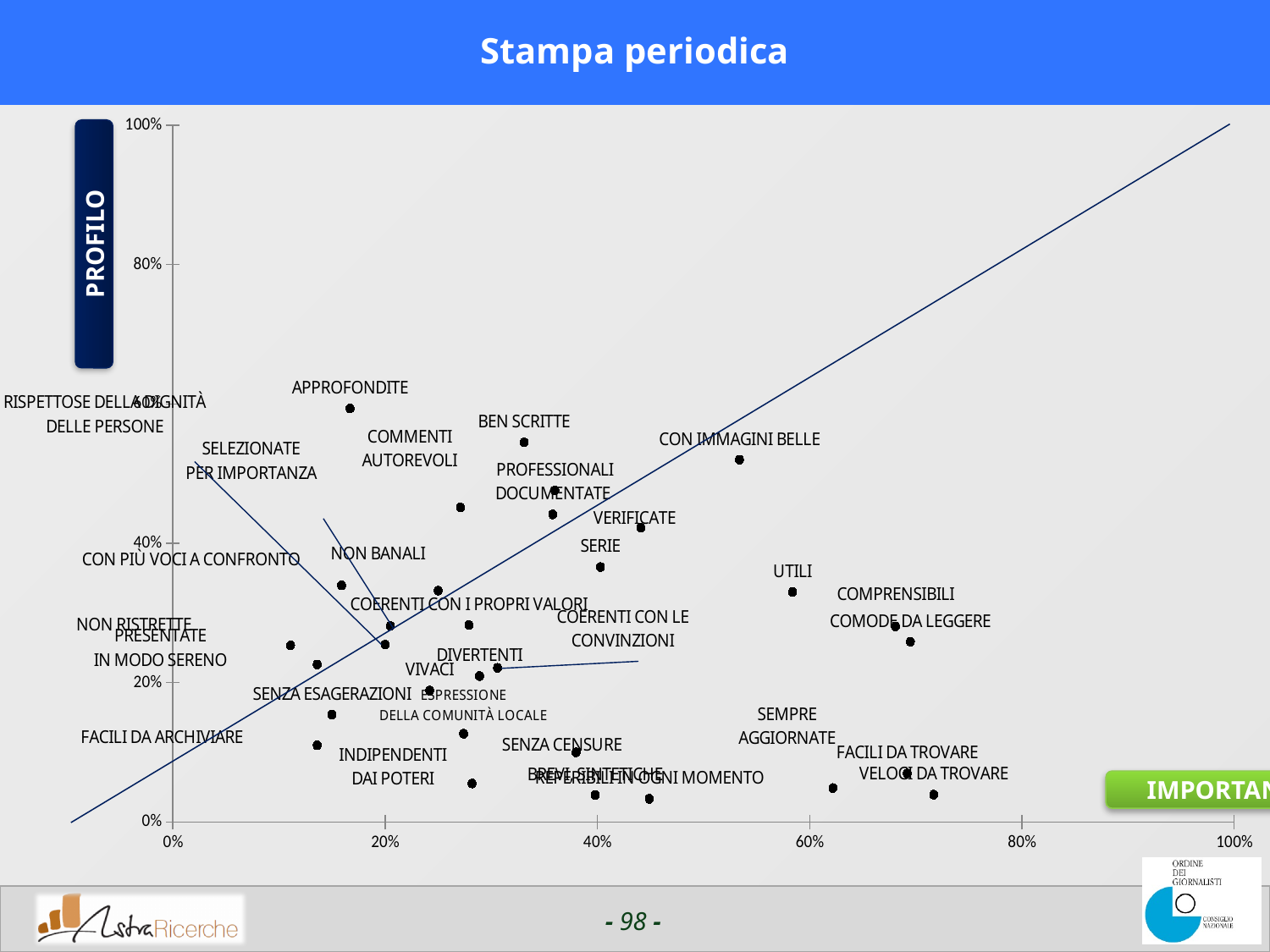
Is the vertical-axis (PROFILO) value for BEN SCRITTE greater or less than 40%? greater What kind of chart is shown on the slide? scatter chart Is the horizontal-axis value for CON IMMAGINI BELLE greater or less than 40%? greater Which labelled point has the highest value on the vertical (PROFILO) axis? APPROFONDITE Is the horizontal-axis value for UTILI greater or less than 40%? greater What is the title of the chart on the slide? Stampa periodica Which point is further right on the horizontal axis, APPROFONDITE or CON IMMAGINI BELLE? CON IMMAGINI BELLE Which point is higher on the vertical (PROFILO) axis, CON IMMAGINI BELLE or UTILI? CON IMMAGINI BELLE What label is shown on the vertical axis of the chart? PROFILO